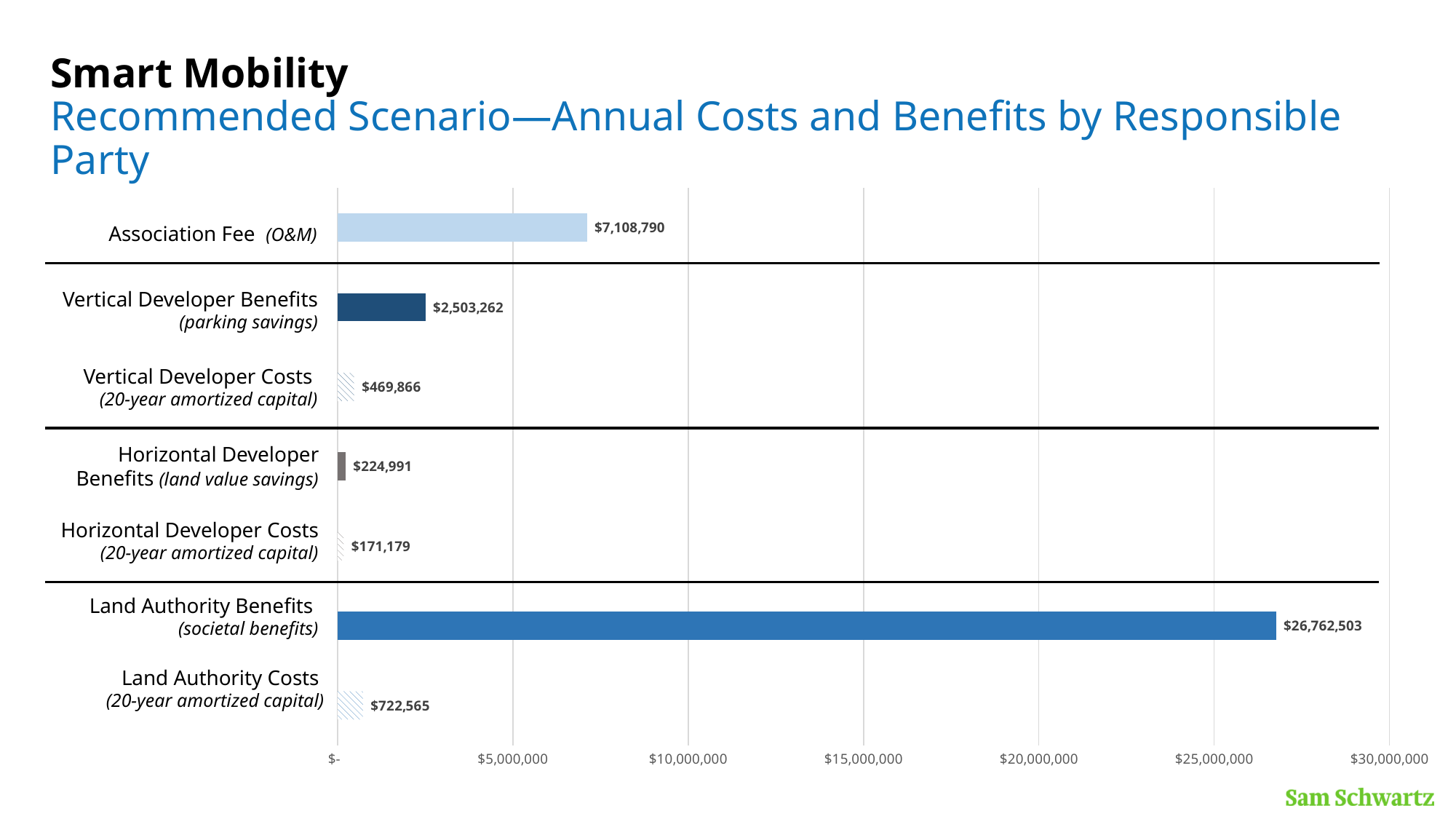
How many categories are plotted in the chart? 7 What kind of chart is shown on the slide? bar chart What is the value for Vertical Developer Costs (20-year amortized capital)? $469,866 What is the difference between Vertical Developer Benefits and Vertical Developer Costs? $2,033,396 What is the value for Association Fee (O&M)? $7,108,790 Which category has the lowest value? Horizontal Developer Costs (20-year amortized capital) Which category has the highest value? Land Authority Benefits (societal benefits) What is the value for Land Authority Benefits (societal benefits)? $26,762,503 What is the difference between Land Authority Benefits and Land Authority Costs? $26,039,938 Which is larger, Association Fee (O&M) or Vertical Developer Benefits (parking savings)? Association Fee (O&M) What is the value for Horizontal Developer Benefits (land value savings)? $224,991 Is the value for Association Fee (O&M) greater or less than $5,000,000? greater